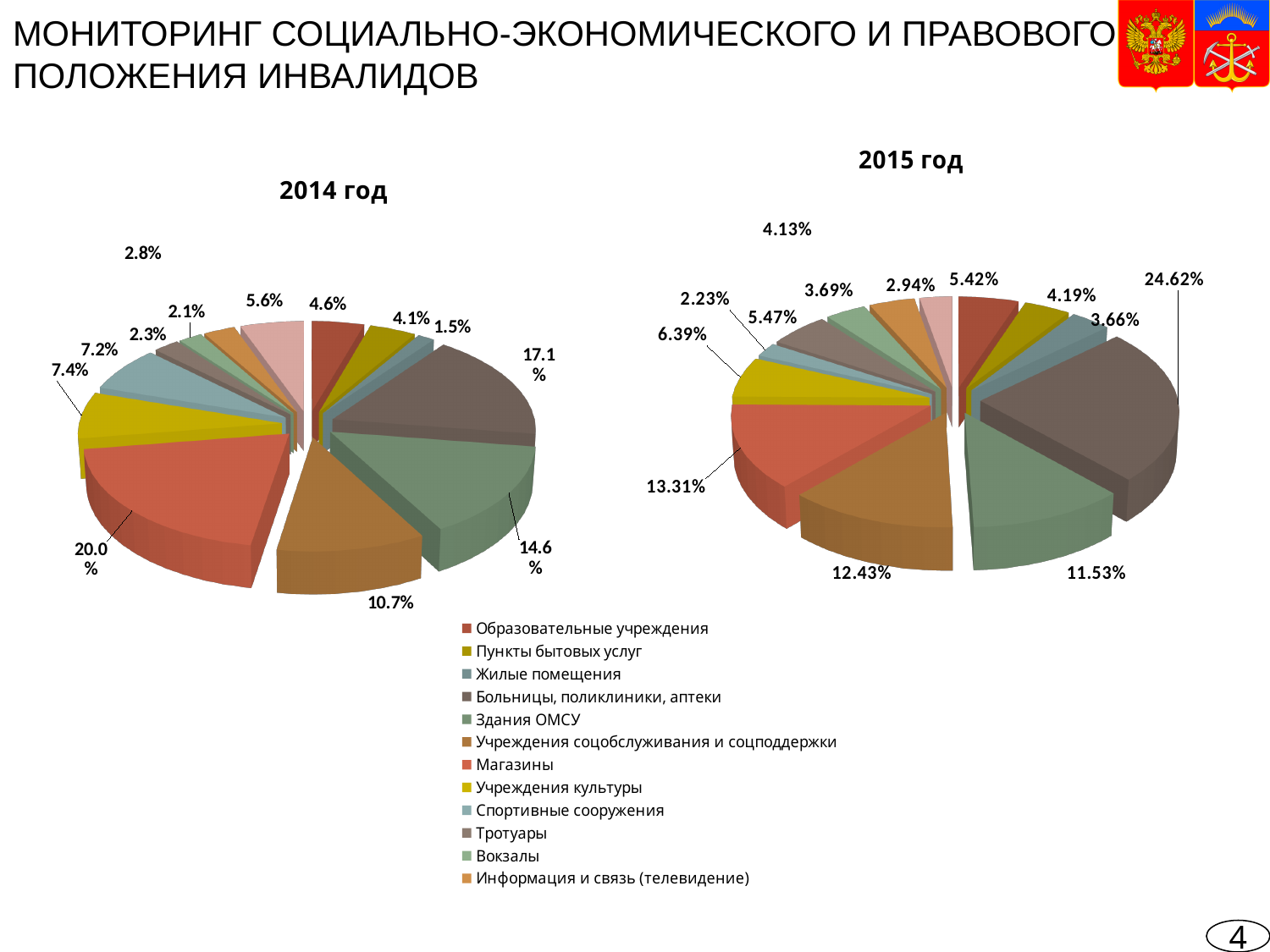
In the "2014 год" chart, what is the largest slice's value? 20.0% In the "2015 год" chart, what is the share for Учреждения соцобслуживания и соцподдержки? 12.43% By how many percentage points does the share for Больницы, поликлиники, аптеки in the "2015 год" chart exceed its share in the "2014 год" chart? 7.52 What kind of chart is used for the "2014 год" chart? pie chart In the "2015 год" chart, what is the share for Больницы, поликлиники, аптеки? 24.62% In the "2014 год" chart, what is the share for Магазины? 20.0% In the "2015 год" chart, what is the largest slice's value? 24.62% In the "2014 год" chart, what is the smallest slice's value? 1.5% Is the share for Магазины larger in the "2014 год" chart or the "2015 год" chart? 2014 год How many entries does the shared legend list? 12 In the "2014 год" chart, what is the share for Здания ОМСУ? 14.6% In the "2015 год" chart, what is the smallest slice's value? 2.23%